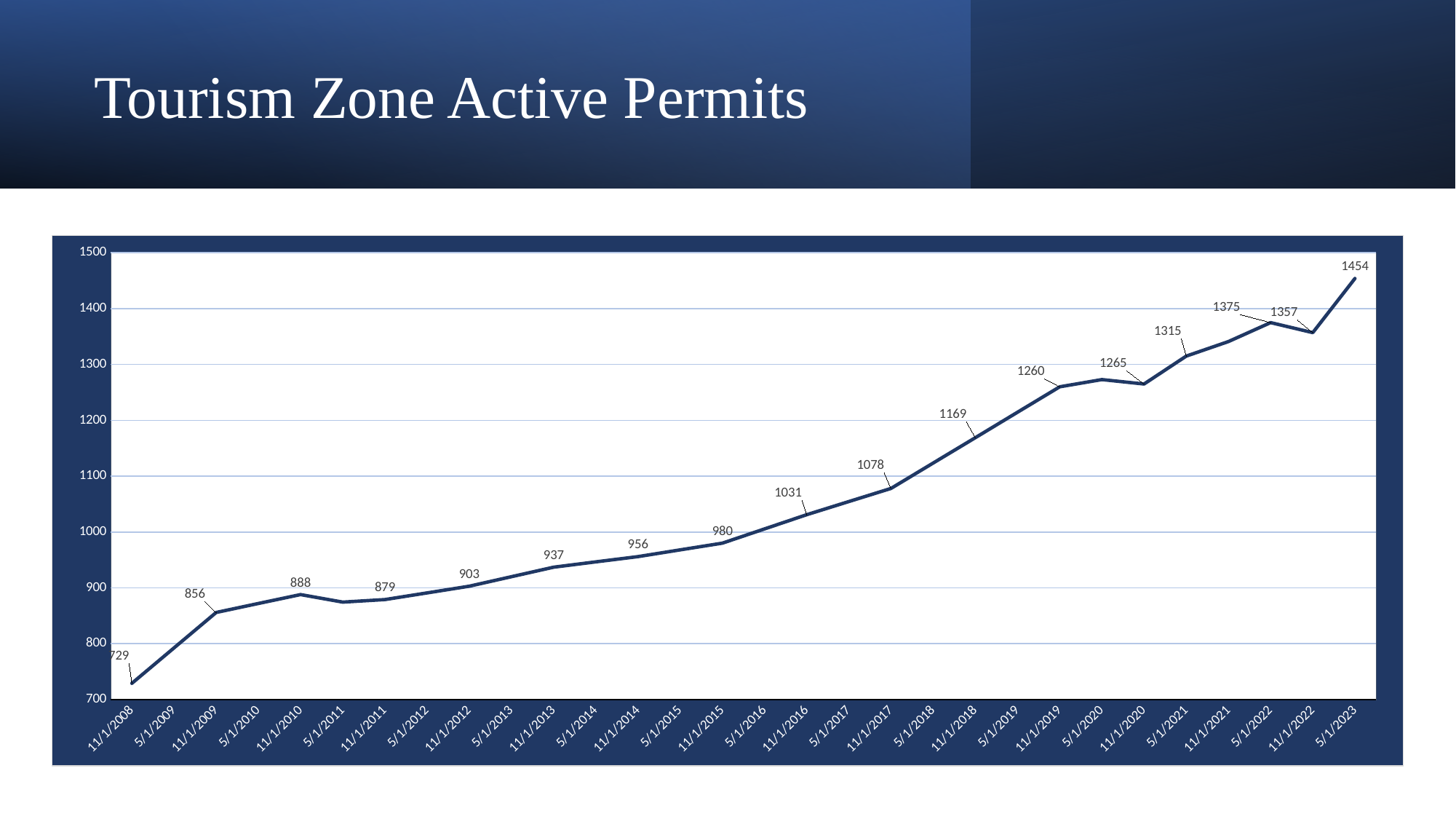
What is the chart's title on the slide? Tourism Zone Active Permits What kind of chart is shown on the slide? line chart Is the value for 5/1/2018 greater or less than 1100? greater What is the value for 11/1/2017? 1078 What is the value for 11/1/2009? 856 Which date has the highest value? 5/1/2023 What is the value for 5/1/2023? 1454 Which date has the lowest value? 11/1/2008 What is the value for 11/1/2008? 729 What is the value for 11/1/2022? 1357 Do the values generally rise or fall from 11/1/2008 to 5/1/2023? rise What is the difference between the value for 5/1/2023 and the value for 11/1/2008? 725